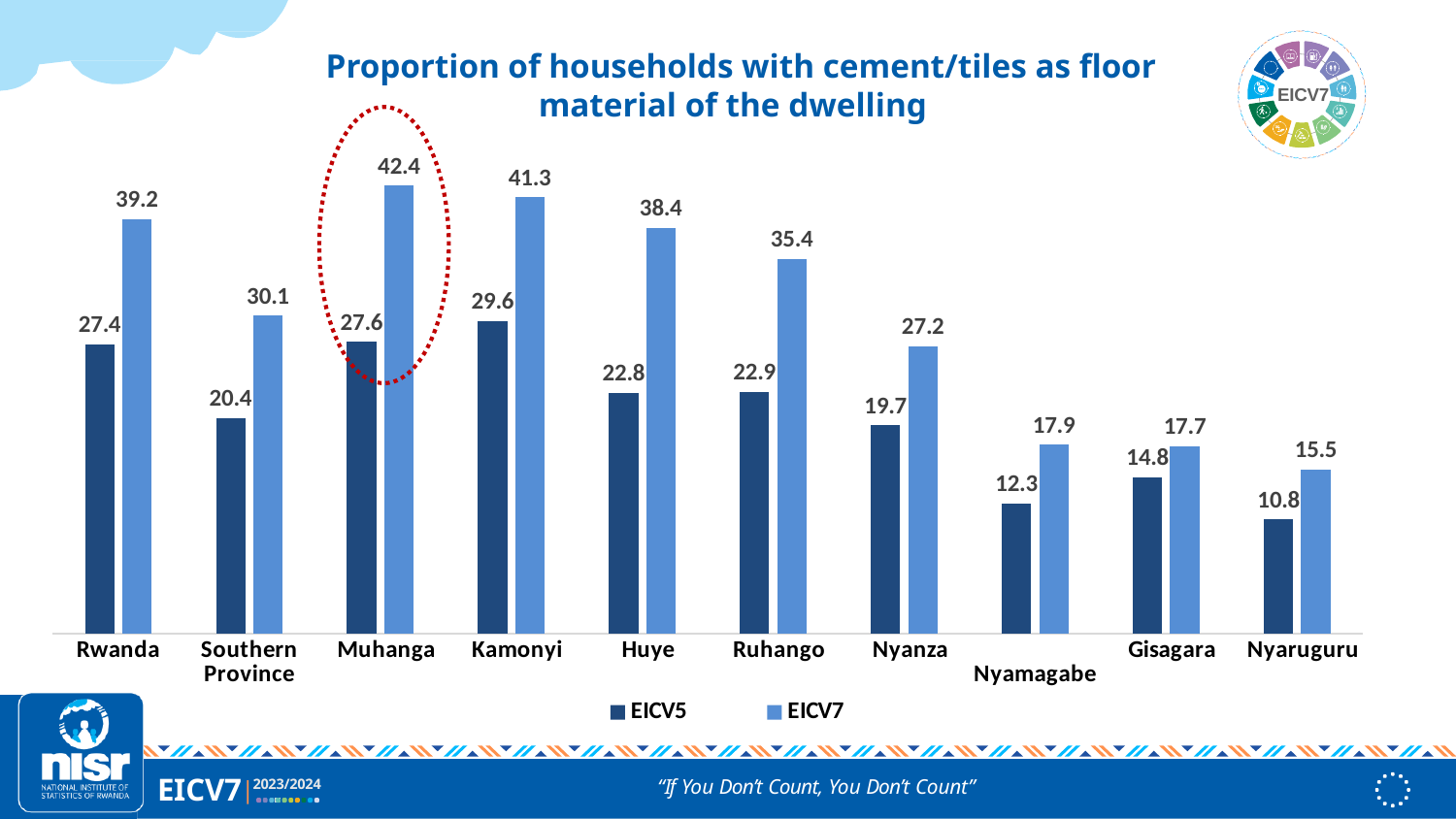
How many series does the legend list? 2 What is the difference between the EICV7 values for Kamonyi and Nyanza? 14.1 Which category is highlighted with a red dotted circle? Muhanga What is the EICV5 value for Southern Province? 20.4 What kind of chart is shown on the slide? Bar chart Which category has the highest EICV7 value? Muhanga What is the difference between the EICV7 and EICV5 values for Huye? 15.6 What is the EICV7 value for Rwanda? 39.2 How many categories are shown on the x axis? 10 Which category has the lowest EICV5 value? Nyaruguru Which is larger, the EICV5 value for Gisagara or the EICV5 value for Nyamagabe? Gisagara What is the EICV7 value for Muhanga? 42.4